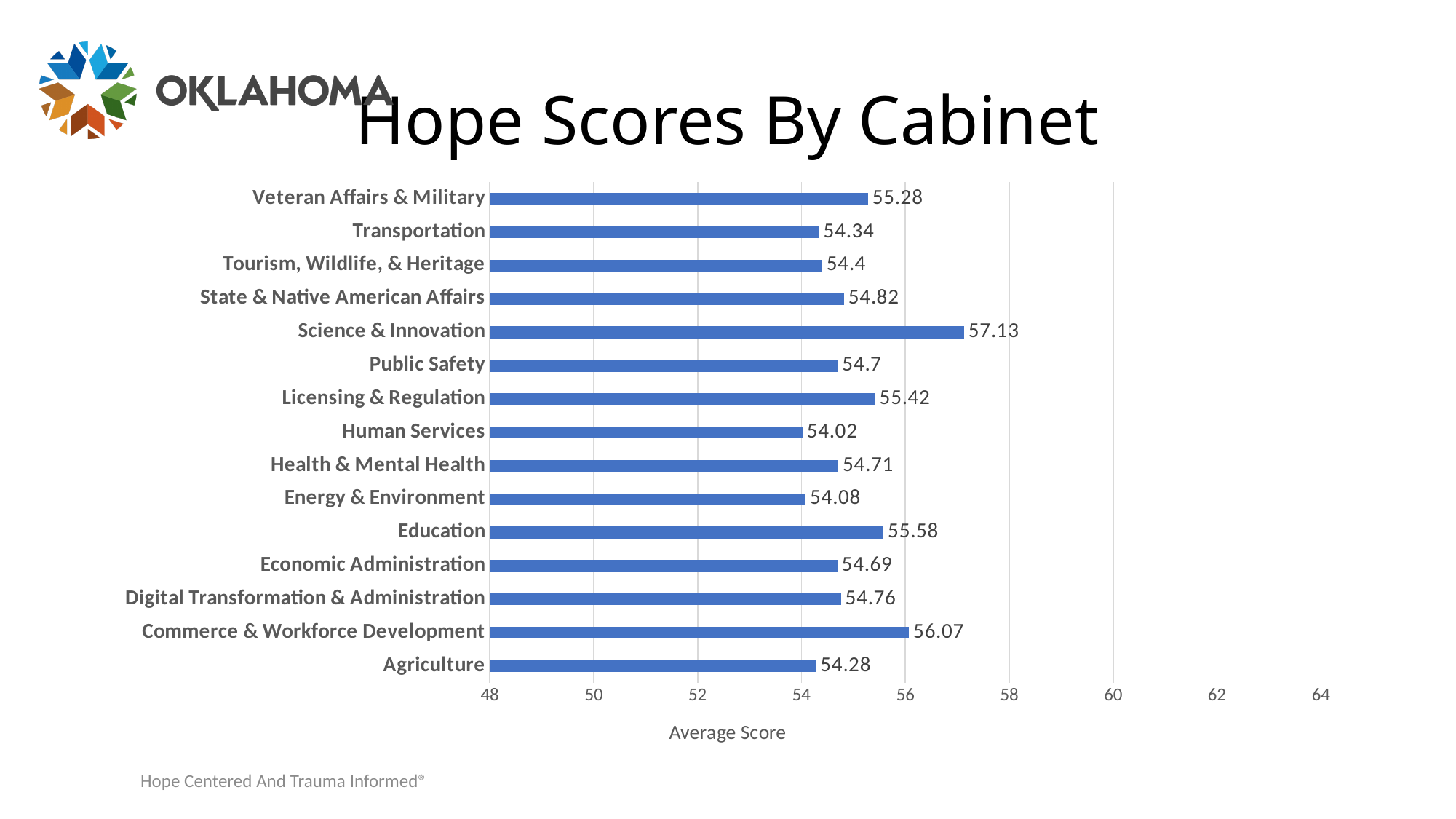
Which cabinet has the lowest average hope score? Human Services Is the value for Science & Innovation greater or less than 56? greater What is the label of the horizontal axis? Average Score What is the average hope score for Agriculture? 54.28 How many cabinets are shown in the chart? 15 What is the title of the chart? Hope Scores By Cabinet What kind of chart is shown on the slide? Bar chart What is the difference between the hope scores of Science & Innovation and Commerce & Workforce Development? 1.06 What is the average hope score for Science & Innovation? 57.13 Which has a higher hope score, Education or Licensing & Regulation? Education Which cabinet has the highest average hope score? Science & Innovation What is the average hope score for Commerce & Workforce Development? 56.07